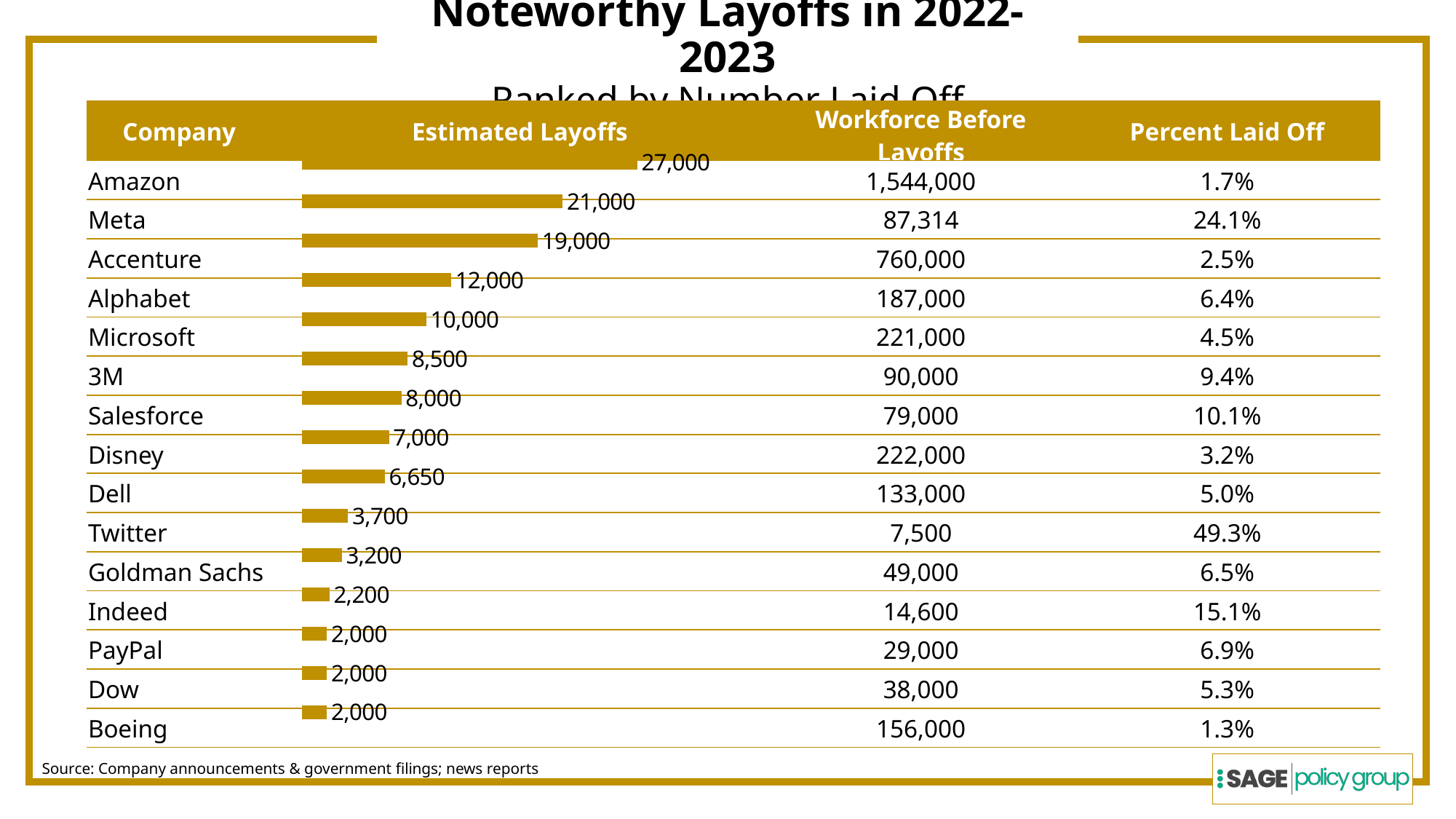
What is the difference between the estimated layoffs for Amazon and Meta? 6,000 What kind of chart is used to show the Estimated Layoffs column? bar chart Do the estimated layoffs bars get longer or shorter going down the list from Amazon to Boeing? shorter What is the estimated number of layoffs shown for Twitter? 3,700 Which has a larger estimated layoffs value, Twitter or Goldman Sachs? Twitter What is the difference between the estimated layoffs for Accenture and Alphabet? 7,000 What is the estimated number of layoffs shown for Meta? 21,000 What is the estimated number of layoffs shown for Amazon? 27,000 Which company has the longest bar for estimated layoffs? Amazon How many companies are shown with bars in the Estimated Layoffs chart? 15 What is the estimated number of layoffs shown for Dell? 6,650 Which has a larger estimated layoffs value, Alphabet or Microsoft? Alphabet